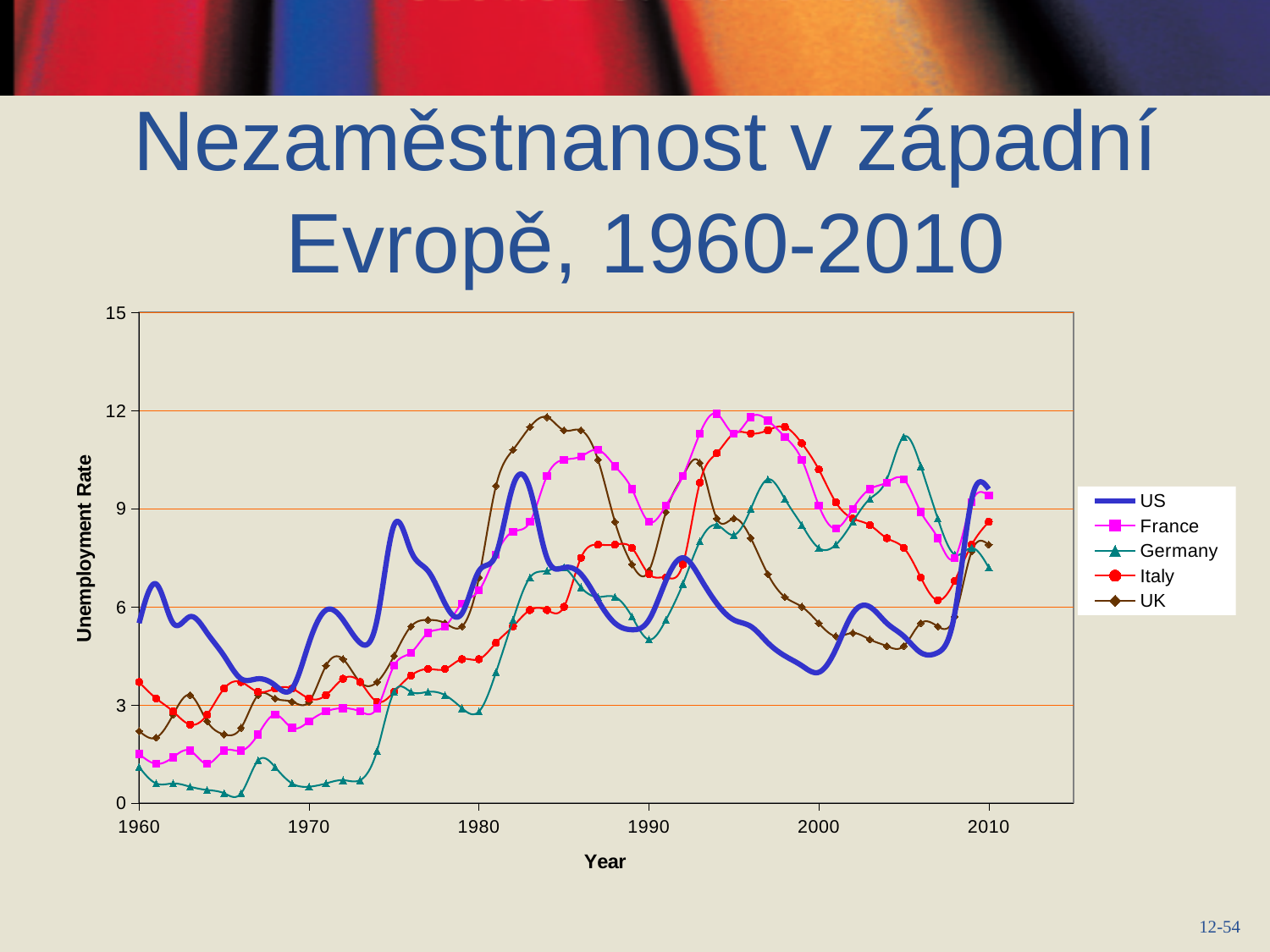
In 1985, which series has a higher unemployment rate, France or Germany? France In 1960, which series has a higher unemployment rate, Italy or Germany? Italy Is the unemployment rate for the UK in 1984 greater or less than 9? greater Is the unemployment rate for the US in 1960 greater or less than 3? greater What is the label of the vertical axis? Unemployment Rate Is the unemployment rate for Germany in 1960 greater or less than 3? less Which countries are listed in the chart's legend? US, France, Germany, Italy, UK How many series does the legend list? 5 Which series has the highest unemployment rate in 1960? US What kind of chart is shown on the slide? line chart